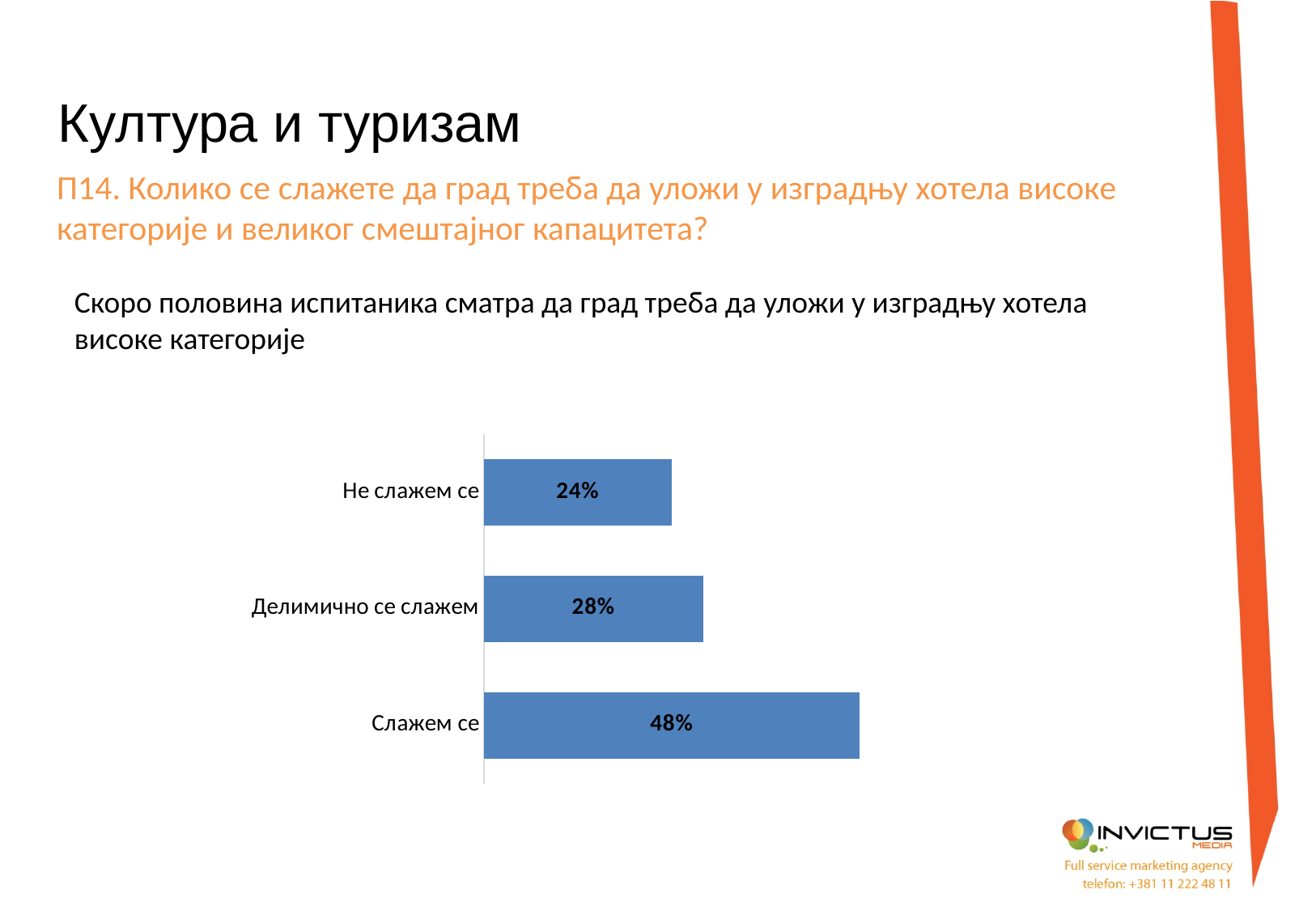
What is the difference between the values for "Слажем се" and "Не слажем се"? 24% Which category has the lowest value? Не слажем се How many categories are shown in the chart? 3 What is the value for "Слажем се"? 48% Which category has the highest value? Слажем се What is the difference between the values for "Делимично се слажем" and "Не слажем се"? 4% Which is larger, the value for "Делимично се слажем" or the value for "Не слажем се"? Делимично се слажем What colour are the bars in the chart? Blue What is the value for "Делимично се слажем"? 28% What kind of chart is shown on the slide? Bar chart Are the bars in the chart horizontal or vertical? Horizontal What is the value for "Не слажем се"? 24%